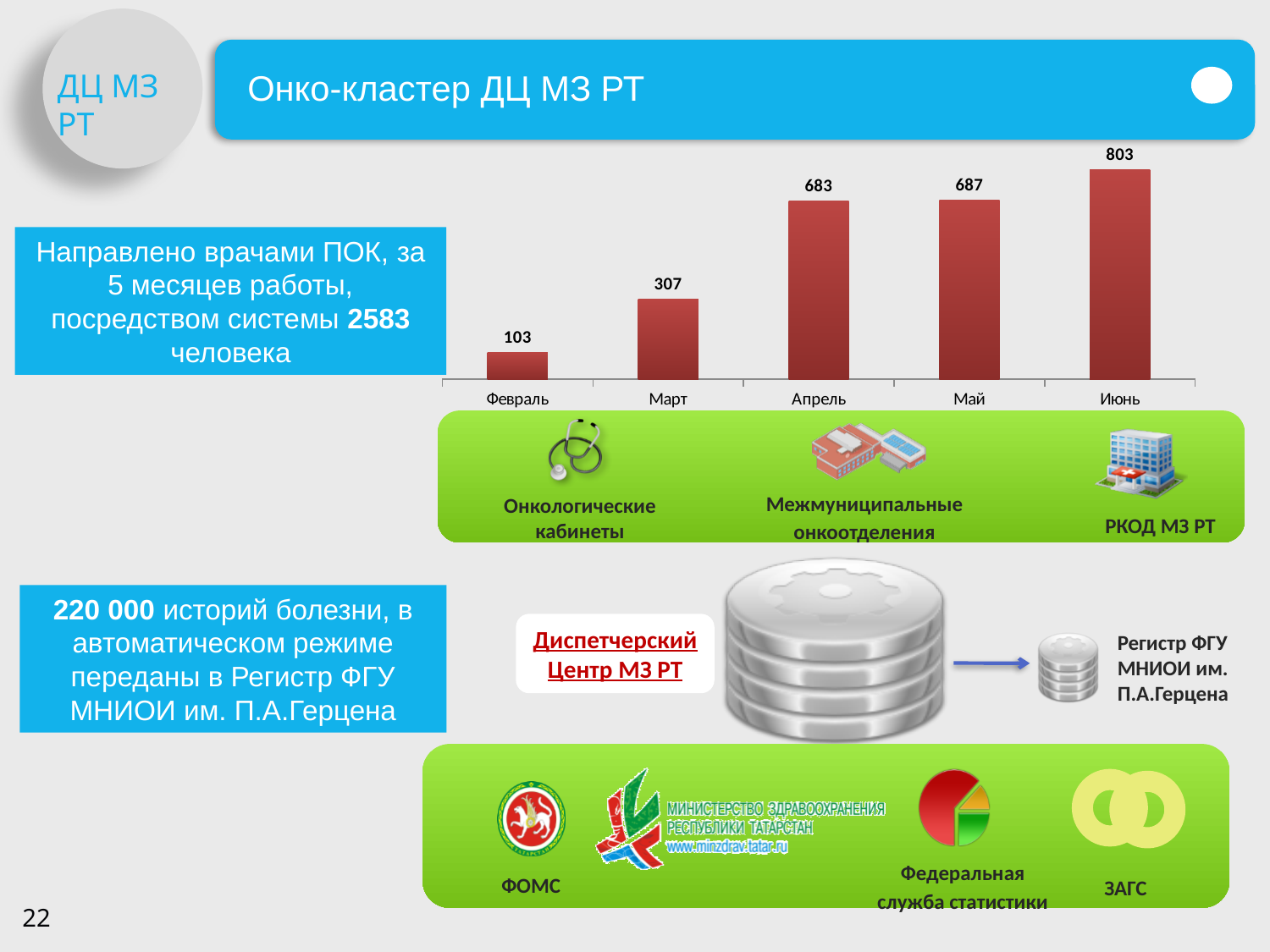
What kind of chart is shown on the slide? bar chart What is the difference between the values for Июнь and Февраль? 700 Which is larger, the value for Март or the value for Апрель? Апрель How many months are shown on the x axis of the chart? 5 What is the difference between the values for Май and Апрель? 4 What is the value for Февраль? 103 What is the value for Июнь? 803 What is the value for Апрель? 683 What is the value for Март? 307 What is the value for Май? 687 Which month has the lowest value? Февраль Which month has the highest value? Июнь